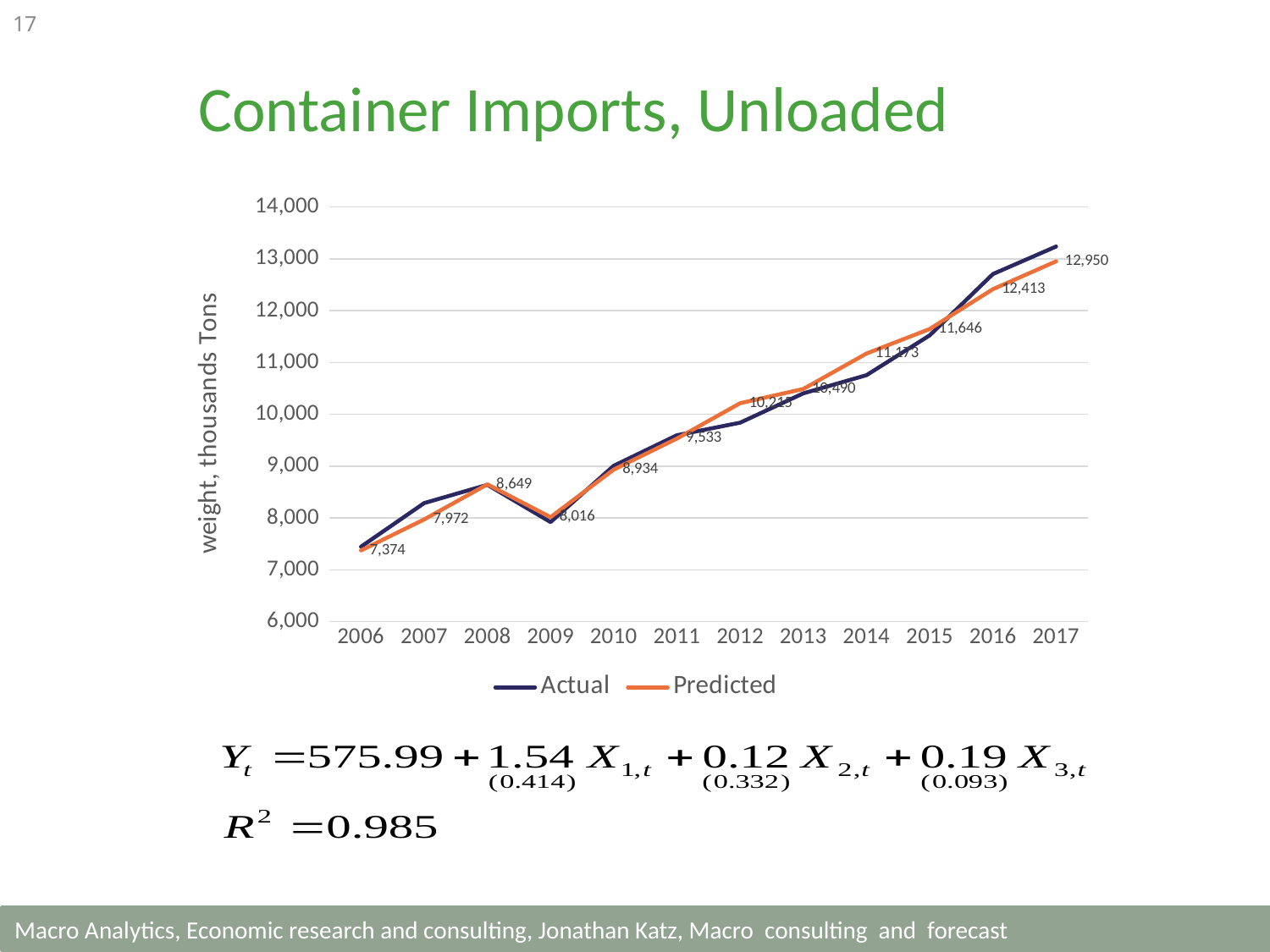
By how much does the Predicted value increase from 2016 to 2017? 537 What kind of chart is shown on the slide? line chart What is the Predicted value for 2009? 8,016 Is the Actual value for 2007 greater or less than 8,000? greater In which year is the Predicted value lowest? 2006 How many series does the legend list? 2 Is the Actual value for 2017 greater or less than 13,000? greater In 2017, which series has the higher value, Actual or Predicted? Actual How many years are shown on the x axis? 12 What is the Predicted value for 2017? 12,950 What is the difference between the Predicted values for 2008 and 2007? 677 What is the Predicted value for 2006? 7,374